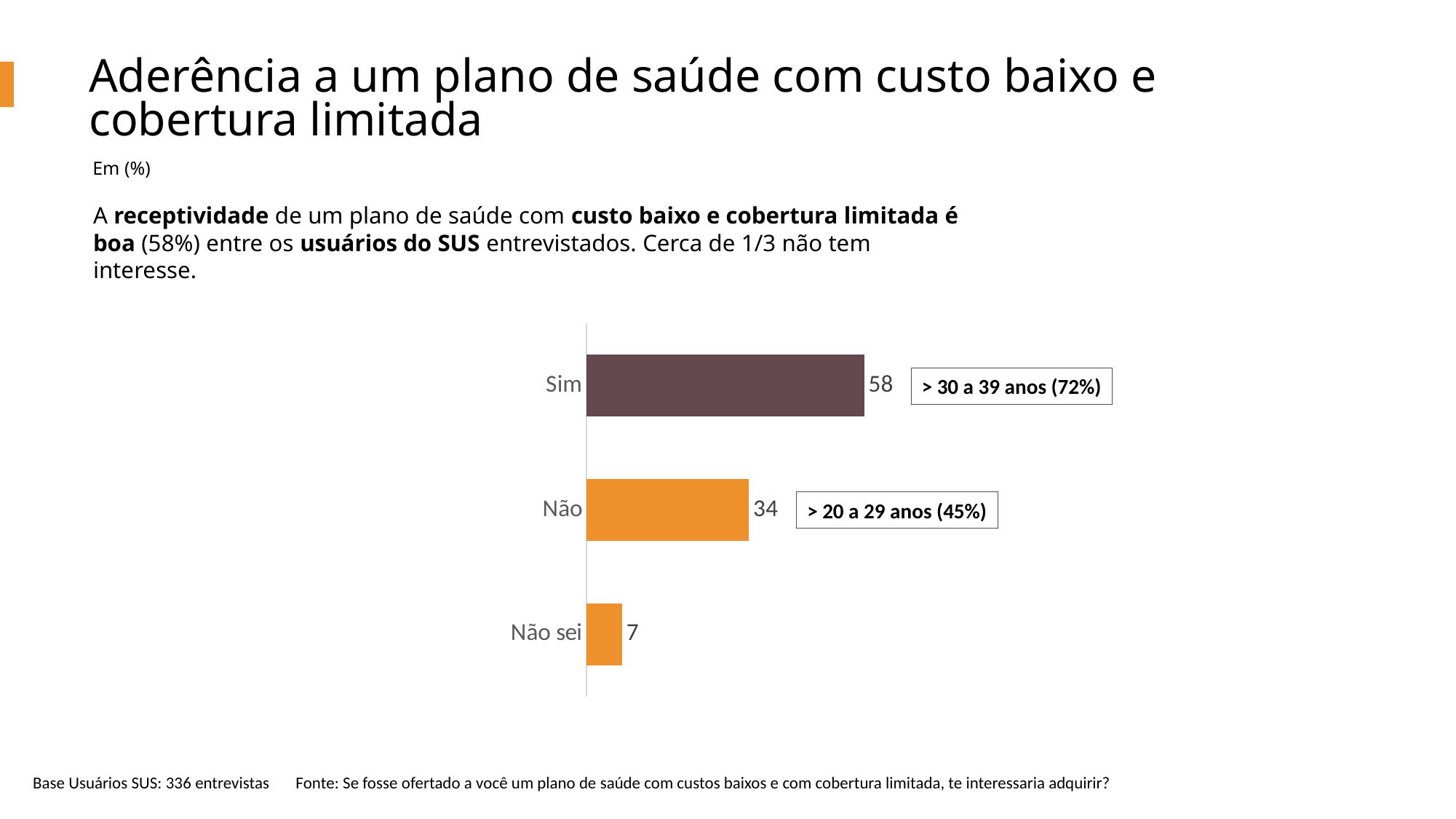
How many categories are shown in the chart? 3 Which category has the lowest value? Não sei What is the value for Sim? 58 What is the difference between the values for Não and Não sei? 27 What is the difference between the values for Sim and Não? 24 What is the value for Não sei? 7 What is the value for Não? 34 What kind of chart is shown on the slide? Bar chart What does the annotation box next to the Sim bar say? > 30 a 39 anos (72%) Which is larger, the value for Não or the value for Não sei? Não What is the total of the three values shown in the chart? 99 Which category has the highest value? Sim